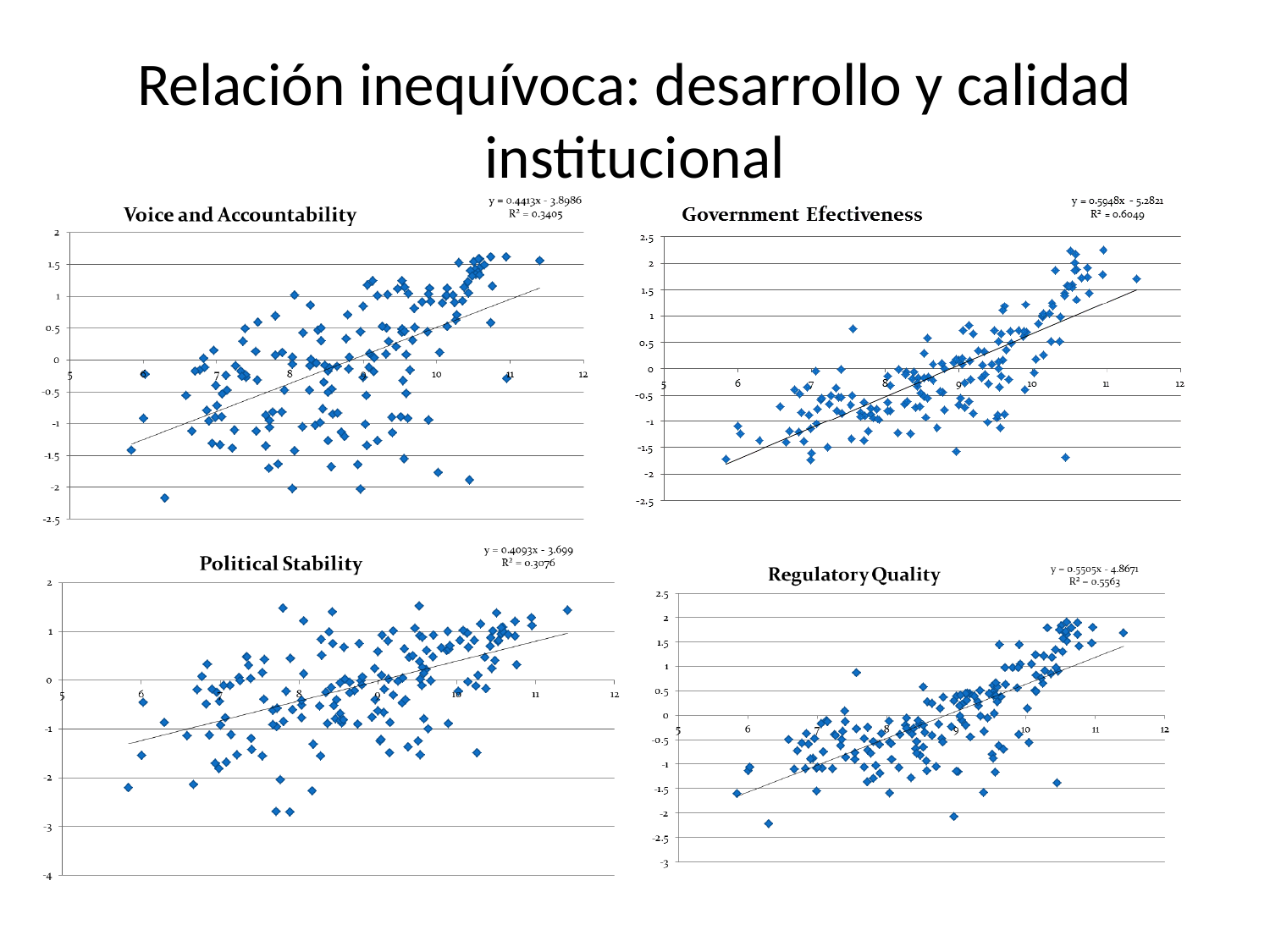
What is the R² value printed above the "Government Efectiveness" chart? 0.6049 What is the title of the chart in the bottom-right of the slide? Regulatory Quality What is the R² value printed above the "Political Stability" chart? 0.3076 In the "Regulatory Quality" chart, does the trend line rise or fall from left to right? rise In the "Political Stability" chart, do the values generally rise or fall along the x axis? rise What is the title of the chart in the top-left of the slide? Voice and Accountability What kind of chart is the "Voice and Accountability" chart? scatter chart In the "Voice and Accountability" chart, do the values generally rise or fall as the x-axis increases? rise Which chart has the larger printed R² value, "Voice and Accountability" or "Government Efectiveness"? Government Efectiveness What is the trend line equation printed above the "Regulatory Quality" chart? y = 0.5505x - 4.8671 How many charts are shown on the slide? 4